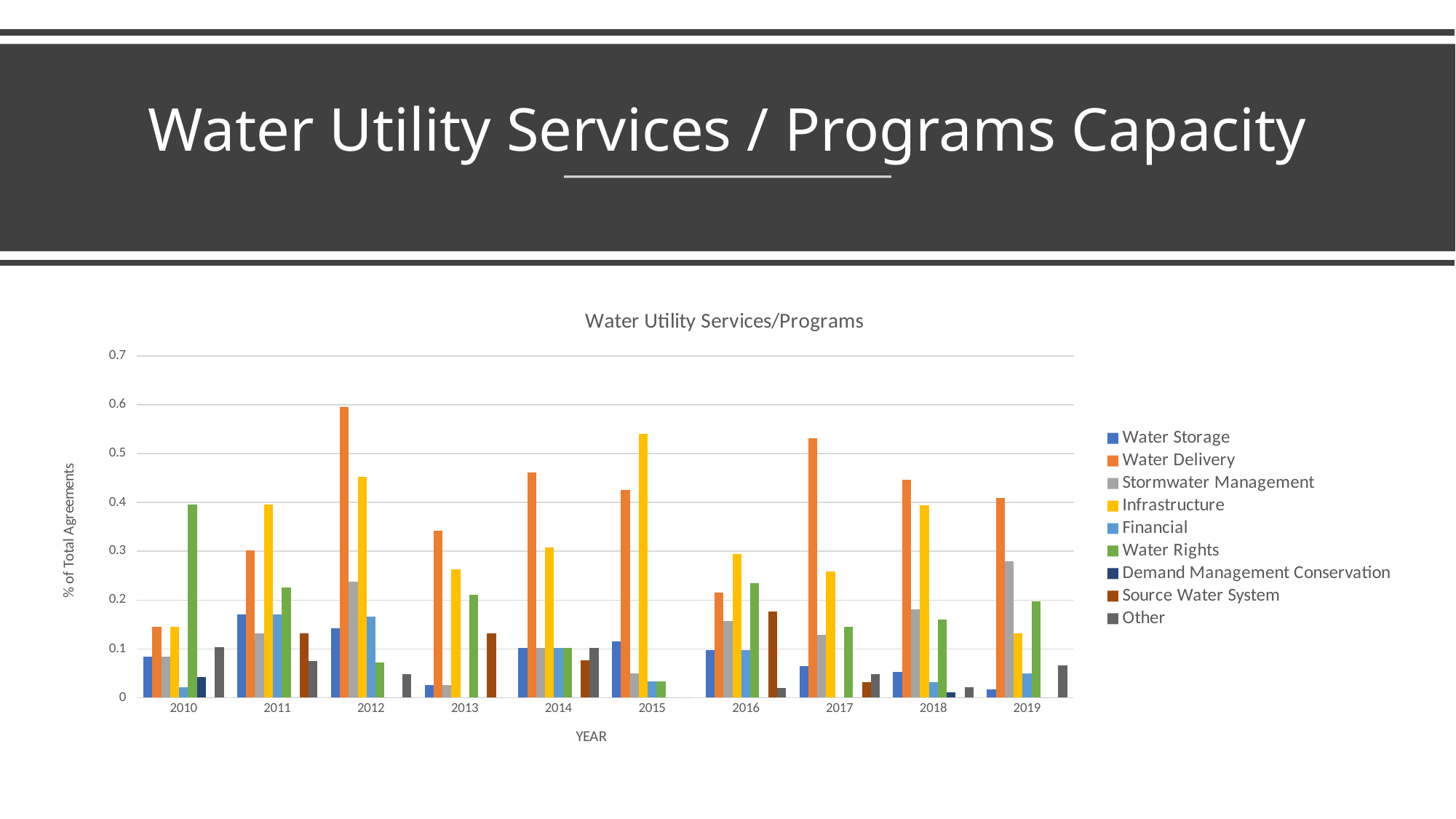
What is the label of the vertical axis? % of Total Agreements How many series does the legend list? 9 Is the Stormwater Management value for 2019 greater or less than 0.2? greater How many years are shown on the x axis? 10 Is the Infrastructure value for 2015 greater or less than 0.5? greater In which year is the Water Delivery value highest? 2012 Is the Water Delivery value for 2012 greater or less than 0.5? greater In which year is the Water Rights value highest? 2010 In which year is the Infrastructure value highest? 2015 In 2015, which is larger: Infrastructure or Water Delivery? Infrastructure What kind of chart is shown on the slide? Bar chart In 2010, which is larger: Water Rights or Water Delivery? Water Rights